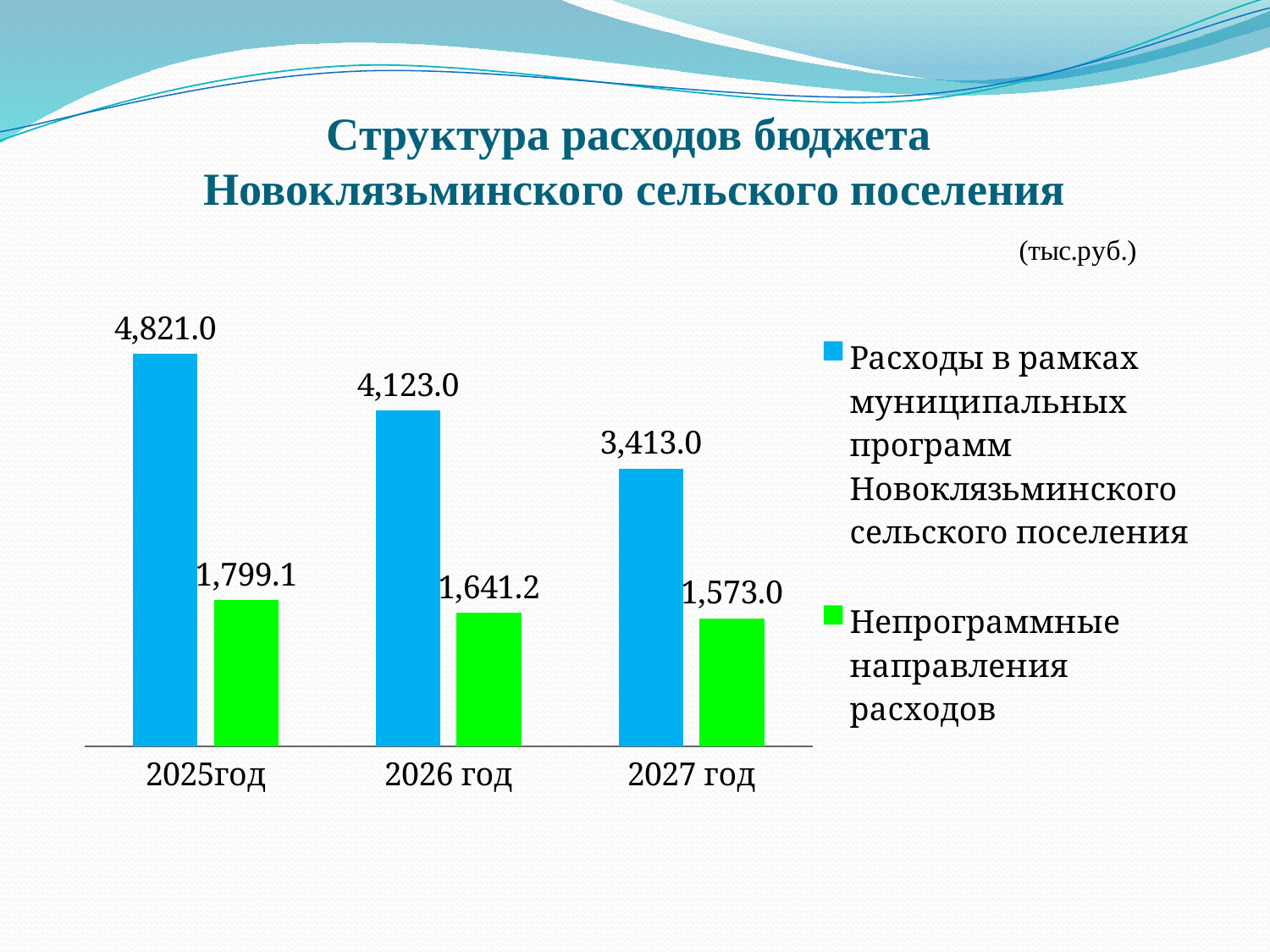
Do the values for 'Непрограммные направления расходов' rise or fall from 2025 год to 2027 год? fall In which year is the value for 'Расходы в рамках муниципальных программ Новоклязьминского сельского поселения' highest? 2025год In which year is the value for 'Непрограммные направления расходов' lowest? 2027 год What is the value for 'Расходы в рамках муниципальных программ Новоклязьминского сельского поселения' in 2025 год? 4,821.0 Which is larger in 2026 год: 'Расходы в рамках муниципальных программ Новоклязьминского сельского поселения' or 'Непрограммные направления расходов'? Расходы в рамках муниципальных программ Новоклязьминского сельского поселения What is the value for 'Непрограммные направления расходов' in 2027 год? 1,573.0 How many series does the legend list? 2 What is the value for 'Непрограммные направления расходов' in 2026 год? 1,641.2 What is the value for 'Расходы в рамках муниципальных программ Новоклязьминского сельского поселения' in 2027 год? 3,413.0 How many years are shown on the x axis of the chart? 3 What is the difference between the two series' values in 2025 год? 3,021.9 By how much does the value for 'Расходы в рамках муниципальных программ Новоклязьминского сельского поселения' fall from 2026 год to 2027 год? 710.0